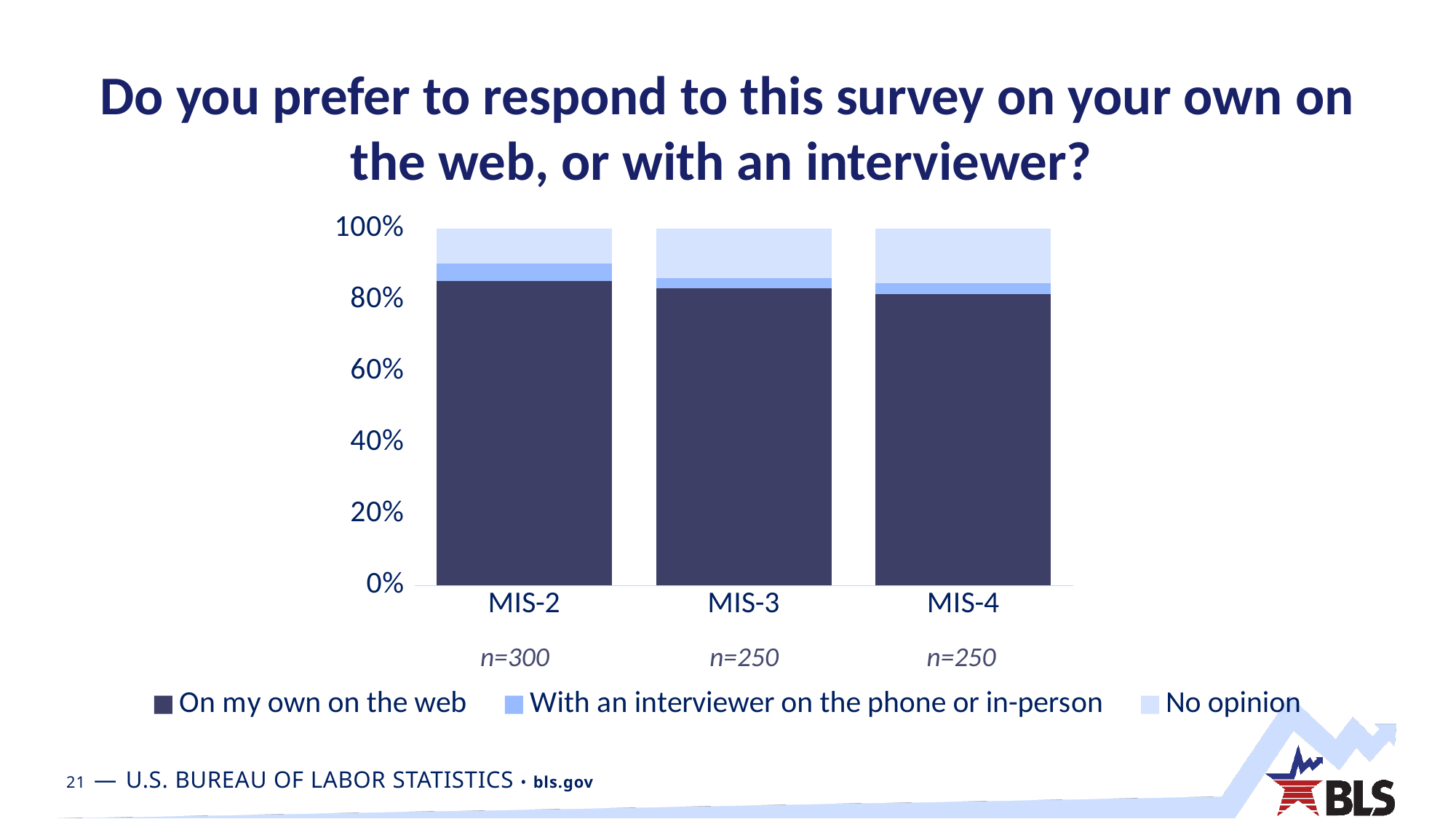
Is the 'On my own on the web' share larger for MIS-2 or for MIS-4? MIS-2 Which category has the smallest share for 'No opinion'? MIS-2 Is the value for 'No opinion' for MIS-4 greater or less than 20%? less What kind of chart is shown on the slide? Stacked bar chart Is the value for 'On my own on the web' for MIS-3 greater or less than 60%? greater What sample size (n) is shown for MIS-2? n=300 Which category has the largest share for 'On my own on the web'? MIS-2 Does the 'On my own on the web' share rise or fall from MIS-2 to MIS-4? Fall How many series does the chart's legend list? 3 Is the value for 'With an interviewer on the phone or in-person' for MIS-2 greater or less than 20%? less How many categories are shown on the x axis of the chart? 3